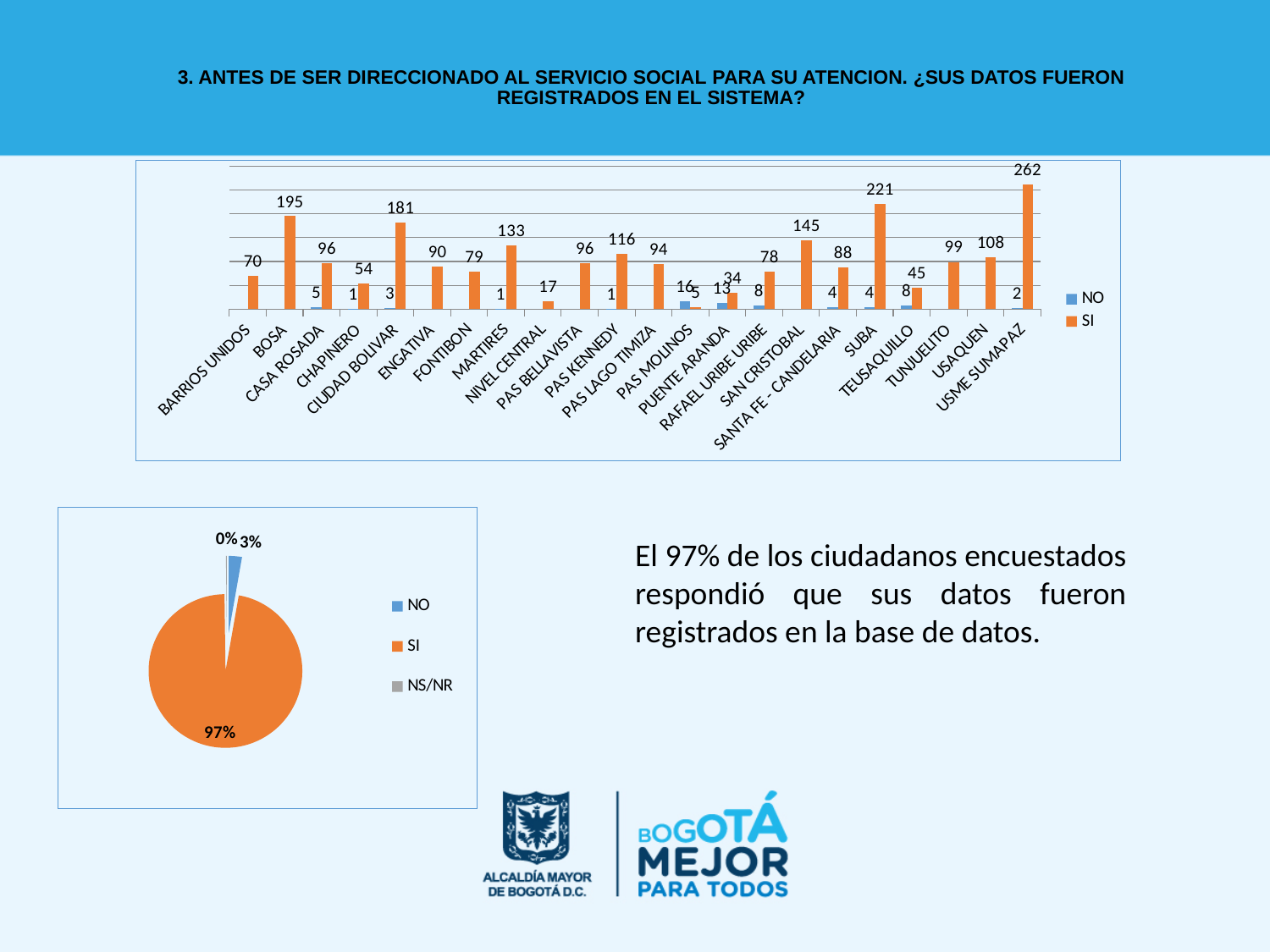
What kind of chart is the chart at the top of the slide? Bar chart In the bar chart, what is the SI value for USME SUMAPAZ? 262 In the bar chart, which category has the highest SI value? USME SUMAPAZ How many entries does the legend of the pie chart list? 3 In the bar chart, what is the SI value for SAN CRISTOBAL? 145 How many categories are shown on the x axis of the bar chart? 22 In the bar chart, what is the NO value for PAS MOLINOS? 16 How many series does the legend of the bar chart list? 2 In the pie chart, what share does the SI slice have? 97% In the bar chart, what is the difference between the SI values for SUBA and BOSA? 26 In the bar chart, which category has the lowest SI value? PAS MOLINOS In the bar chart, which has a larger SI value, CIUDAD BOLIVAR or MARTIRES? CIUDAD BOLIVAR